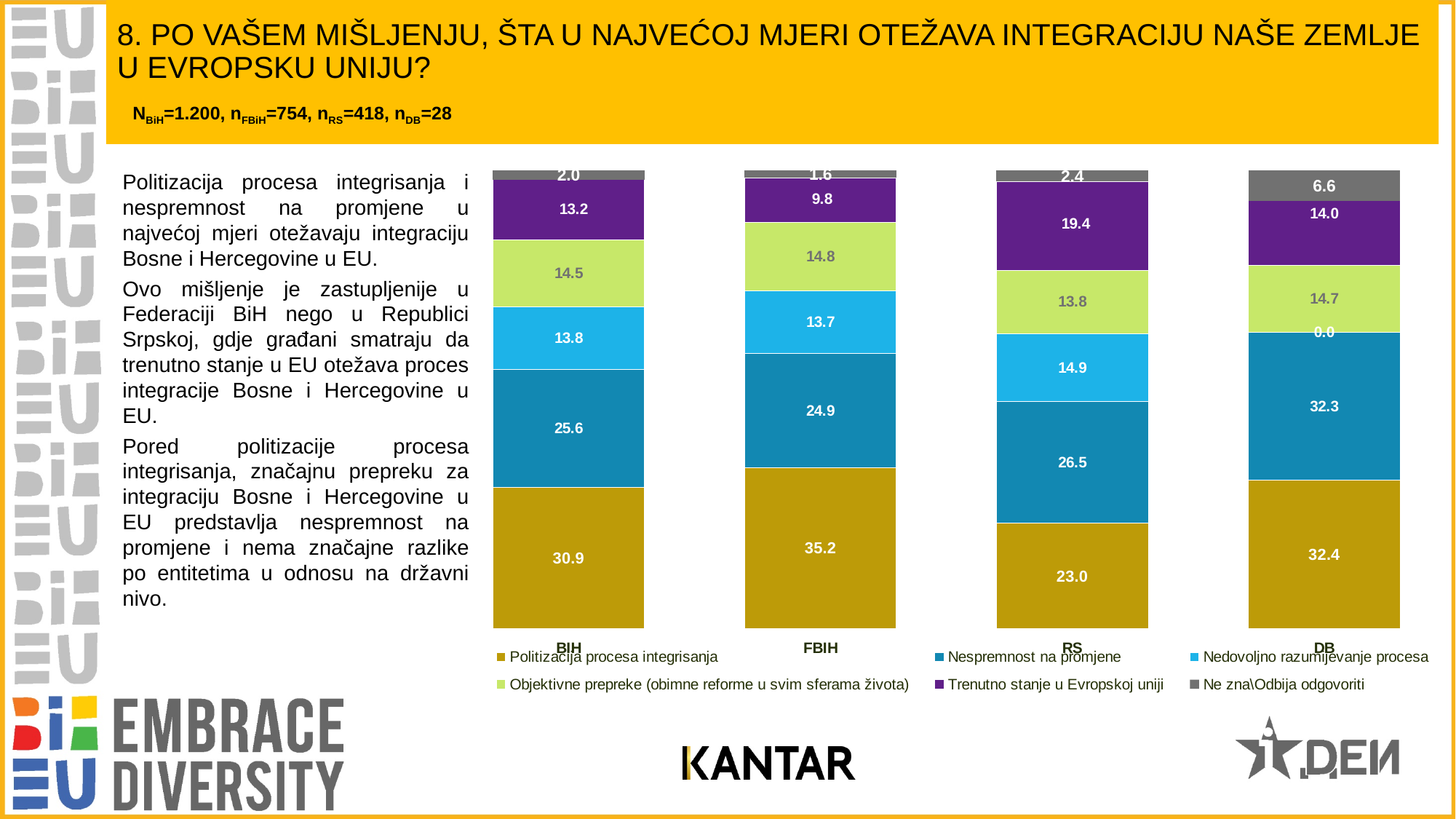
What is the difference between the 'Nespremnost na promjene' values for DB and BIH? 6.7 How many categories (bars) are shown on the x axis? 4 What kind of chart is shown on the slide? Stacked bar chart How many series does the legend list? 6 What is the value of 'Trenutno stanje u Evropskoj uniji' for RS? 19.4 Which category has the highest value for 'Politizacija procesa integrisanja'? FBIH What is the total of the stacked bar for BIH? 100.0 What is the value of 'Ne zna\Odbija odgovoriti' for DB? 6.6 What is the value of 'Nedovoljno razumijevanje procesa' for DB? 0.0 Which is larger: 'Politizacija procesa integrisanja' for RS or 'Nespremnost na promjene' for RS? Nespremnost na promjene for RS What is the value of 'Politizacija procesa integrisanja' for FBIH? 35.2 Which category has the lowest value for 'Trenutno stanje u Evropskoj uniji'? FBIH